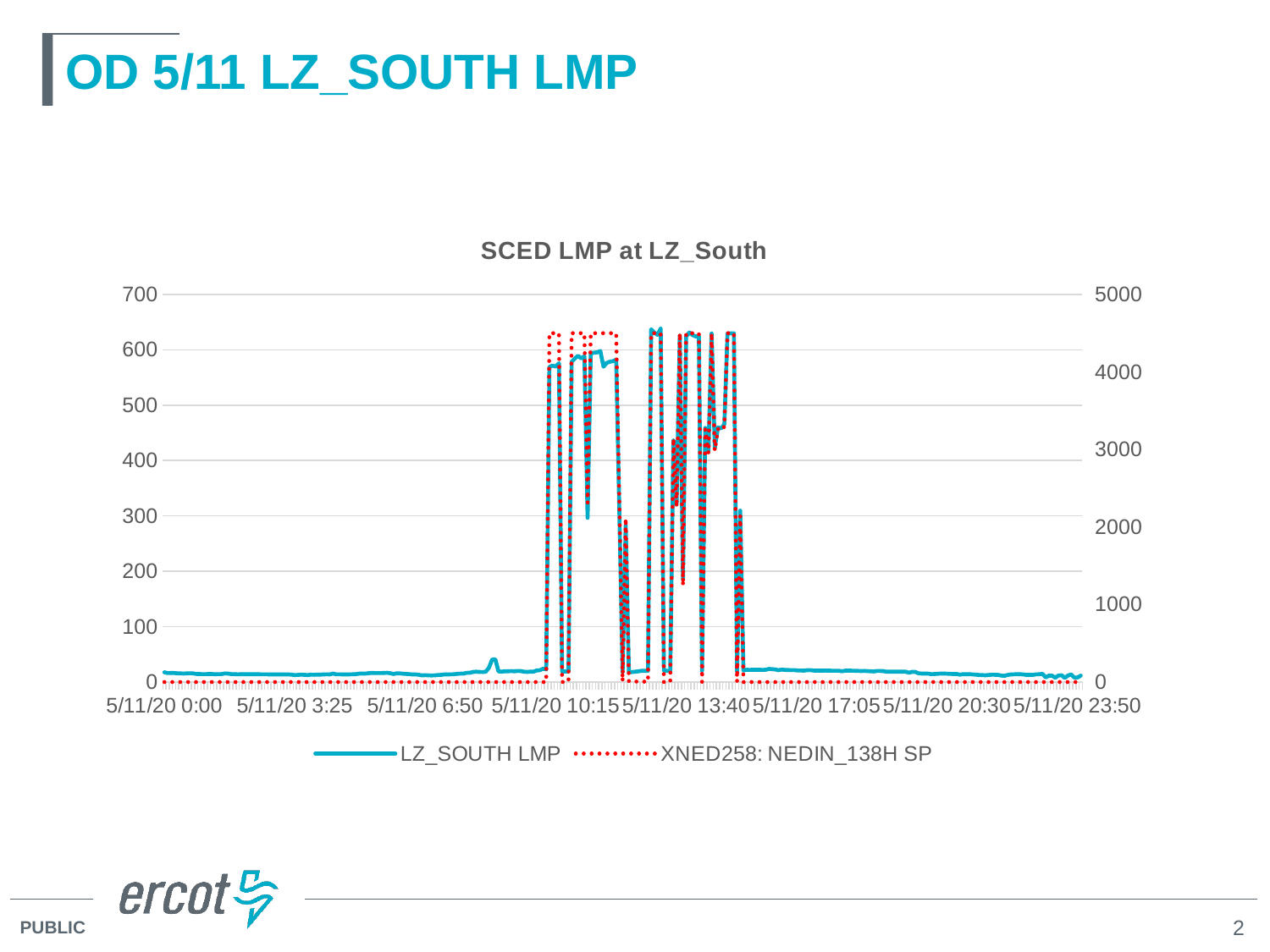
What is the first time label shown on the x axis? 5/11/20 0:00 What is the highest value shown on the right vertical axis? 5000 Is the peak LZ_SOUTH LMP value reached between 5/11/20 10:15 and 5/11/20 13:40 greater or less than 600 on the left axis? greater What is the title of the chart? SCED LMP at LZ_South How many time labels are shown along the x axis? 8 What kind of chart is shown on the slide? line chart Is the LZ_SOUTH LMP value at 5/11/20 3:25 greater or less than 100? less How many series does the legend list? 2 What is the highest value shown on the left vertical axis? 700 Which series is drawn as a dotted red line? XNED258: NEDIN_138H SP Is the LZ_SOUTH LMP value at 5/11/20 20:30 greater or less than 100? less